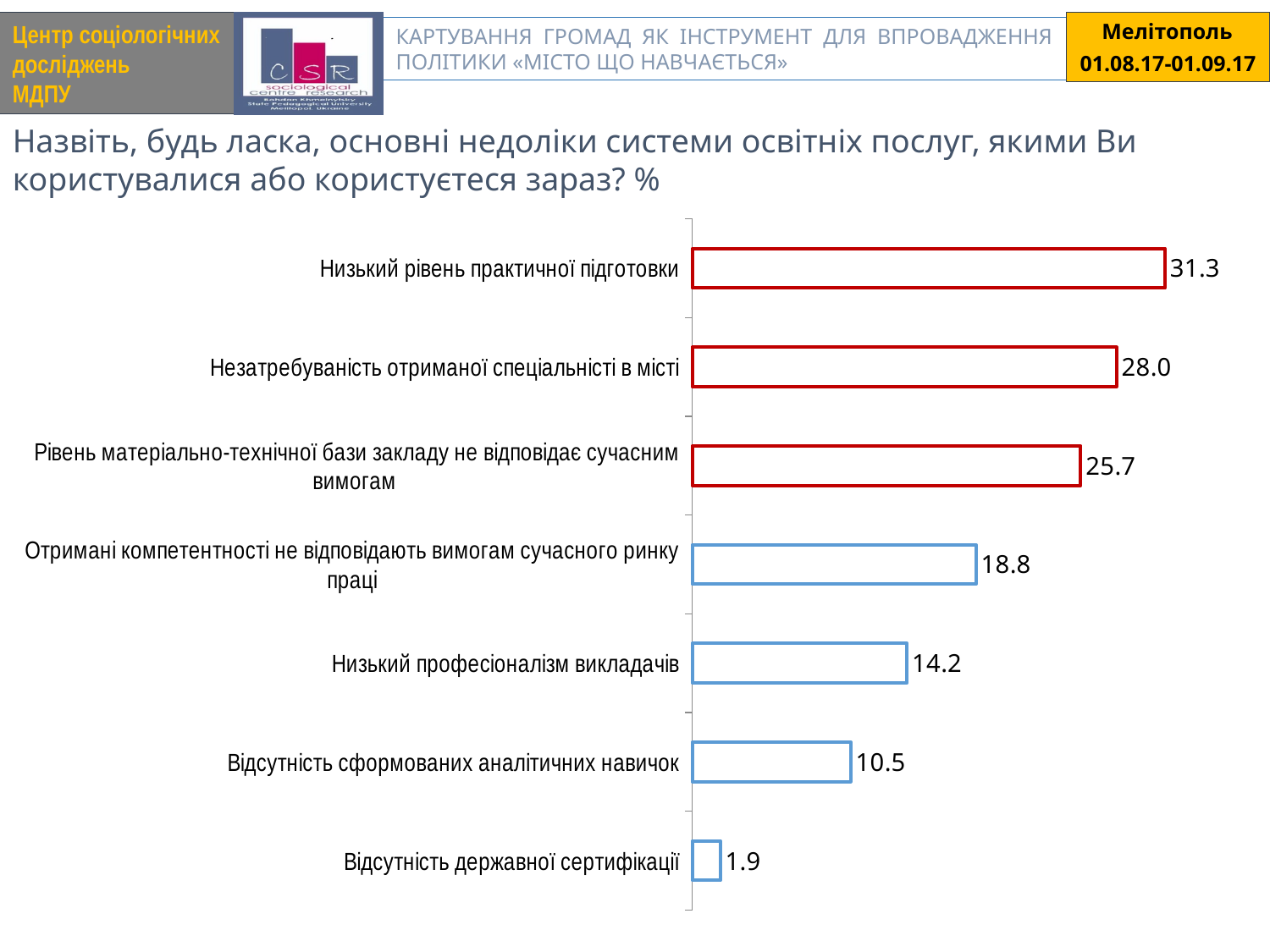
What is the value for «Відсутність сформованих аналітичних навичок»? 10.5 What is the value for «Низький рівень практичної підготовки»? 31.3 Which category has the lowest value? Відсутність державної сертифікації What kind of chart is shown on the slide? Bar chart What is the difference between «Отримані компетентності не відповідають вимогам сучасного ринку праці» and «Низький професіоналізм викладачів»? 4.6 Which category has the highest value? Низький рівень практичної підготовки What is the difference between «Низький рівень практичної підготовки» and «Незатребуваність отриманої спеціальністі в місті»? 3.3 How many categories are shown in the chart? 7 How many bars are outlined in red? 3 Which is larger: «Рівень матеріально-технічної бази закладу не відповідає сучасним вимогам» or «Отримані компетентності не відповідають вимогам сучасного ринку праці»? Рівень матеріально-технічної бази закладу не відповідає сучасним вимогам What is the value for «Незатребуваність отриманої спеціальністі в місті»? 28.0 What is the value for «Низький професіоналізм викладачів»? 14.2